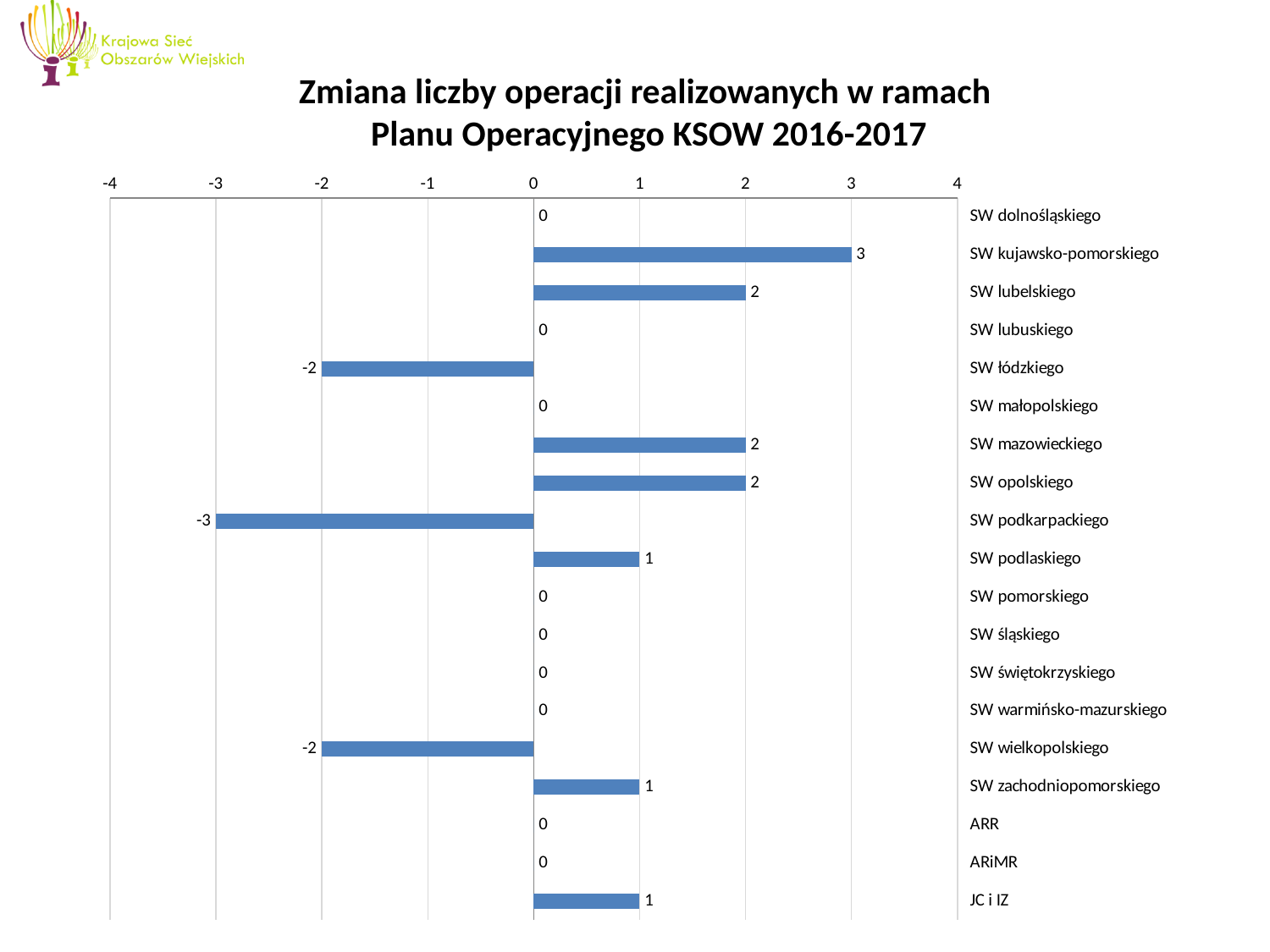
What is the value for SW podkarpackiego? -3 What is the value for SW kujawsko-pomorskiego? 3 What kind of chart is shown on the slide? Bar chart Which category has the highest value? SW kujawsko-pomorskiego What is the value for SW wielkopolskiego? -2 What is the value for SW łódzkiego? -2 What is the difference between the values for SW kujawsko-pomorskiego and SW podlaskiego? 2 How many categories are shown on the chart? 19 What is the value for JC i IZ? 1 Which is larger, the value for SW lubelskiego or the value for SW zachodniopomorskiego? SW lubelskiego What is the title of the chart? Zmiana liczby operacji realizowanych w ramach Planu Operacyjnego KSOW 2016-2017 Which category has the lowest value? SW podkarpackiego